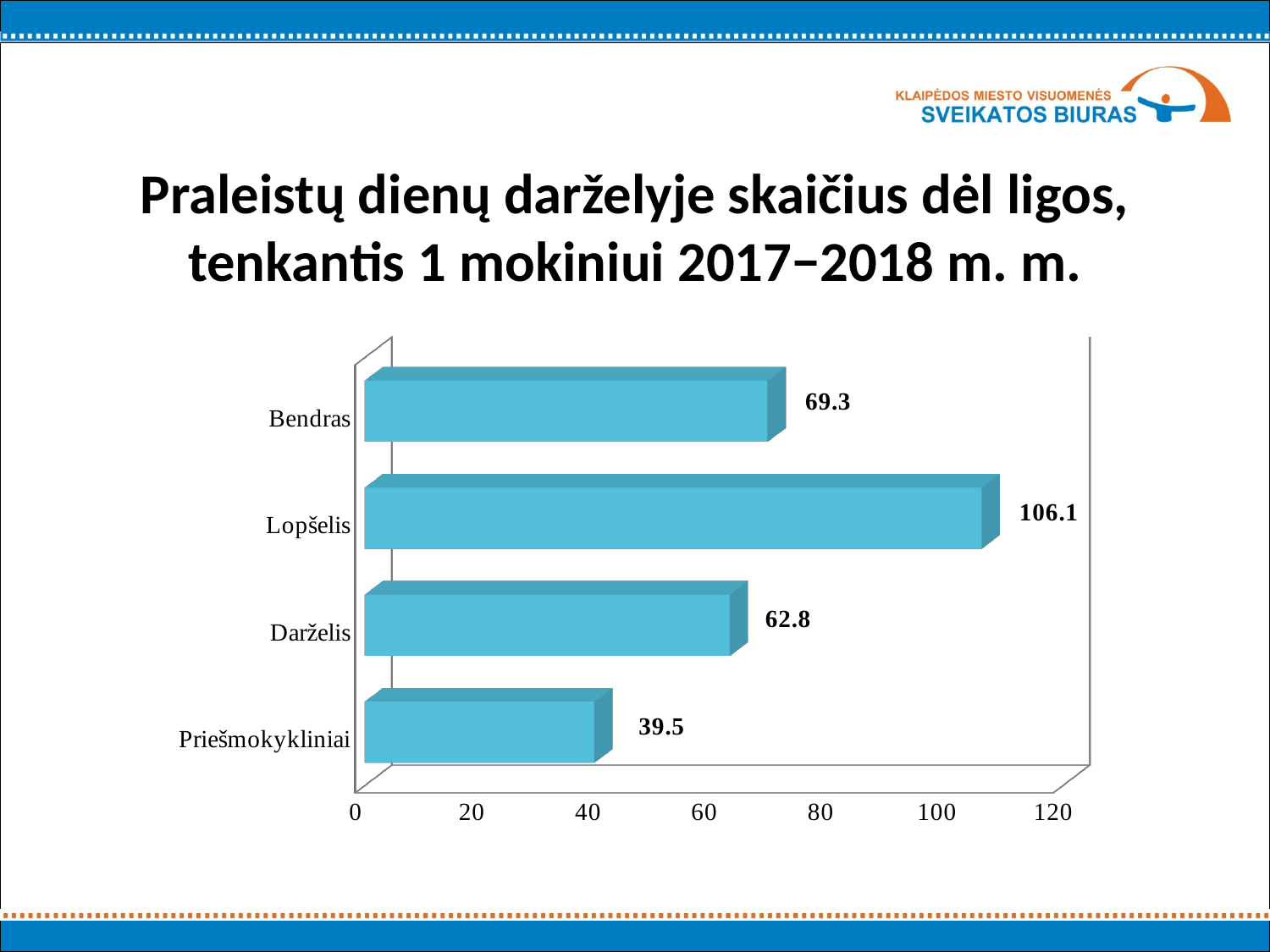
Which is larger, the value for Bendras or the value for Darželis? Bendras What is the value for Darželis? 62.8 Is the value for Lopšelis greater or less than 100? greater What is the value for Bendras? 69.3 What is the difference between the values for Lopšelis and Darželis? 43.3 What kind of chart is shown on the slide? bar chart What is the value for Lopšelis? 106.1 How many categories are shown in the chart? 4 Which category has the lowest value? Priešmokykliniai Which category has the highest value? Lopšelis What is the value for Priešmokykliniai? 39.5 What is the difference between the values for Bendras and Priešmokykliniai? 29.8